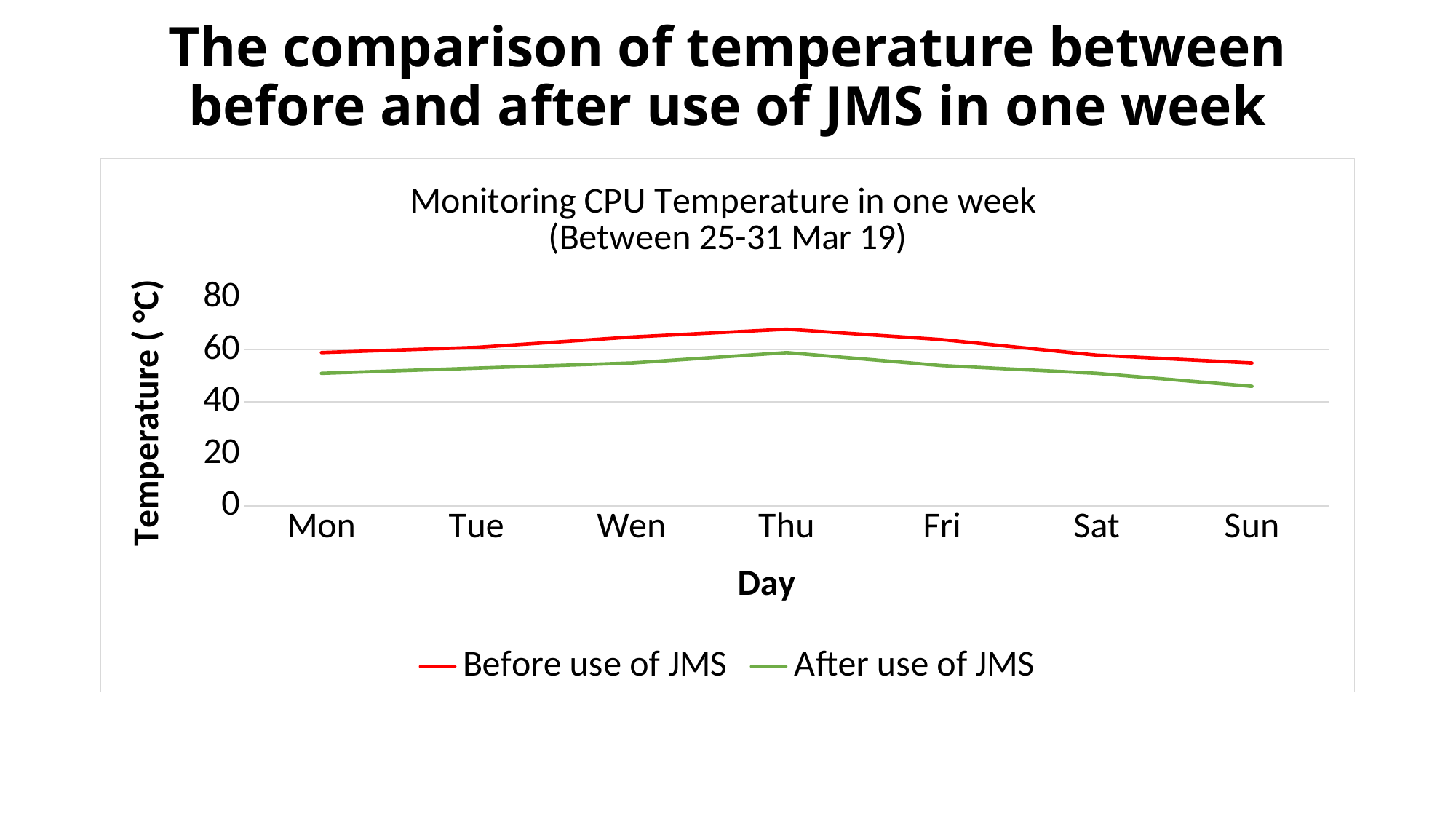
How many series does the legend list? 2 Is the value for 'After use of JMS' on Sun greater or less than 60? less How many days are plotted along the x axis? 7 What kind of chart is shown on the slide? line chart Is the value for 'After use of JMS' on Mon greater or less than 40? greater On which day does the 'After use of JMS' line reach its lowest value? Sun On which day does the 'After use of JMS' line reach its highest value? Thu What colour is the line for 'After use of JMS'? green On which day does the 'Before use of JMS' line reach its highest value? Thu Is the value for 'Before use of JMS' on Thu greater or less than 60? greater On Thu, which series has the larger value, 'Before use of JMS' or 'After use of JMS'? Before use of JMS Do the values of the 'After use of JMS' line rise or fall from Thu to Sun? fall